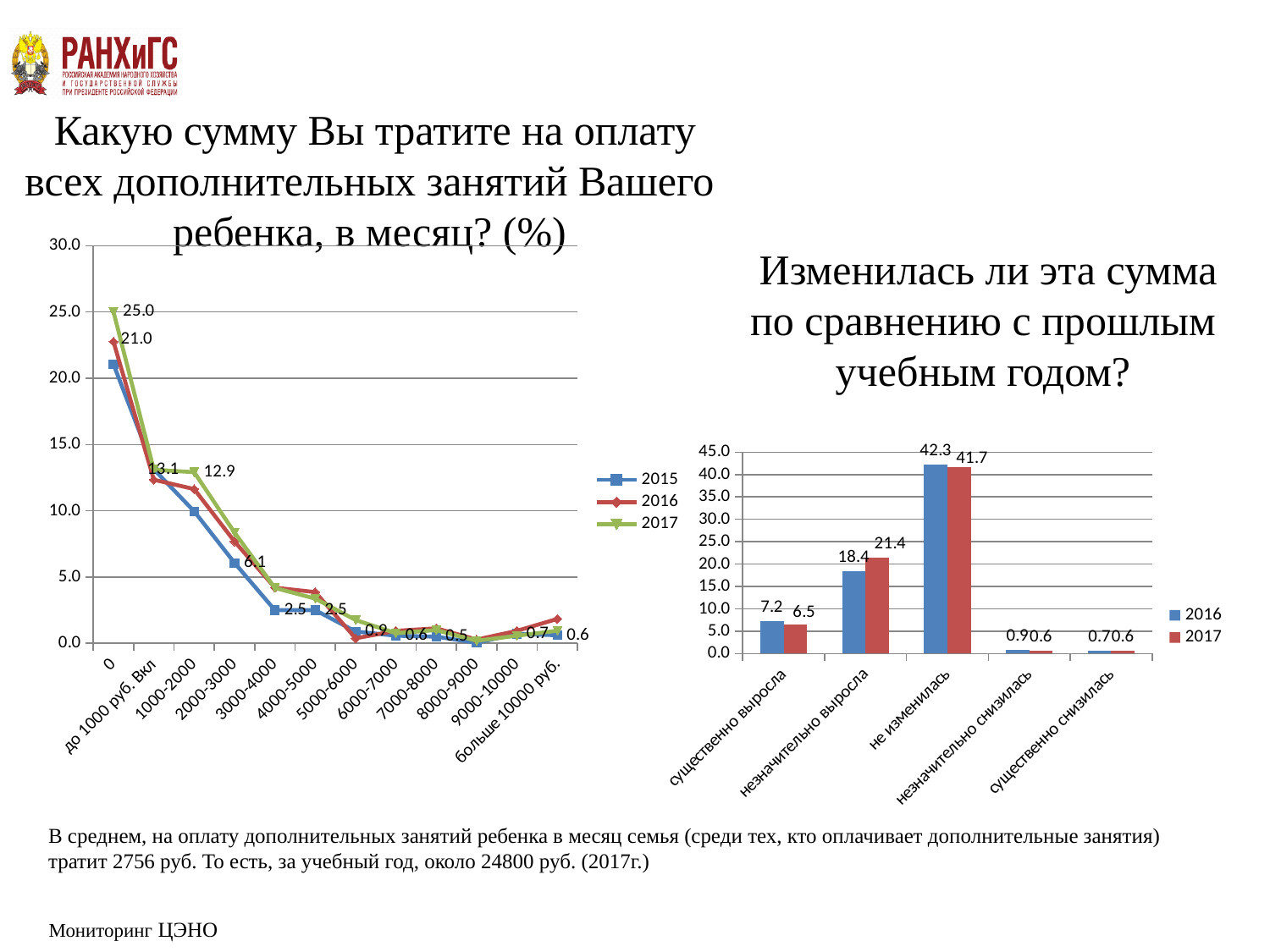
In the chart 'Какую сумму Вы тратите на оплату всех дополнительных занятий Вашего ребенка, в месяц? (%)', do the values generally rise or fall as you move along the x axis from '0' to 'больше 10000 руб.'? fall How many series does the legend list in the chart 'Какую сумму Вы тратите на оплату всех дополнительных занятий Вашего ребенка, в месяц? (%)'? 3 How many categories are shown in the chart 'Изменилась ли эта сумма по сравнению с прошлым учебным годом?'? 5 In the chart 'Изменилась ли эта сумма по сравнению с прошлым учебным годом?', which series has the larger value for 'существенно выросла', 2016 or 2017? 2016 In the chart 'Изменилась ли эта сумма по сравнению с прошлым учебным годом?', what is the value for 2017 in the category 'незначительно выросла'? 21.4 What kind of chart is the one on the right of the slide, 'Изменилась ли эта сумма по сравнению с прошлым учебным годом?'? bar chart In the chart 'Изменилась ли эта сумма по сравнению с прошлым учебным годом?', what is the value for 2016 in the category 'не изменилась'? 42.3 In the chart 'Изменилась ли эта сумма по сравнению с прошлым учебным годом?', what is the difference between the 2017 and 2016 values for 'незначительно выросла'? 3.0 In the chart 'Изменилась ли эта сумма по сравнению с прошлым учебным годом?', which category has the highest value for 2017? не изменилась What kind of chart is the one on the left of the slide, 'Какую сумму Вы тратите на оплату всех дополнительных занятий Вашего ребенка, в месяц? (%)'? line chart In the chart 'Какую сумму Вы тратите на оплату всех дополнительных занятий Вашего ребенка, в месяц? (%)', what is the difference between the 2017 and 2015 values in the category '0'? 4.0 In the chart 'Какую сумму Вы тратите на оплату всех дополнительных занятий Вашего ребенка, в месяц? (%)', what is the value for 2017 in the category '0'? 25.0